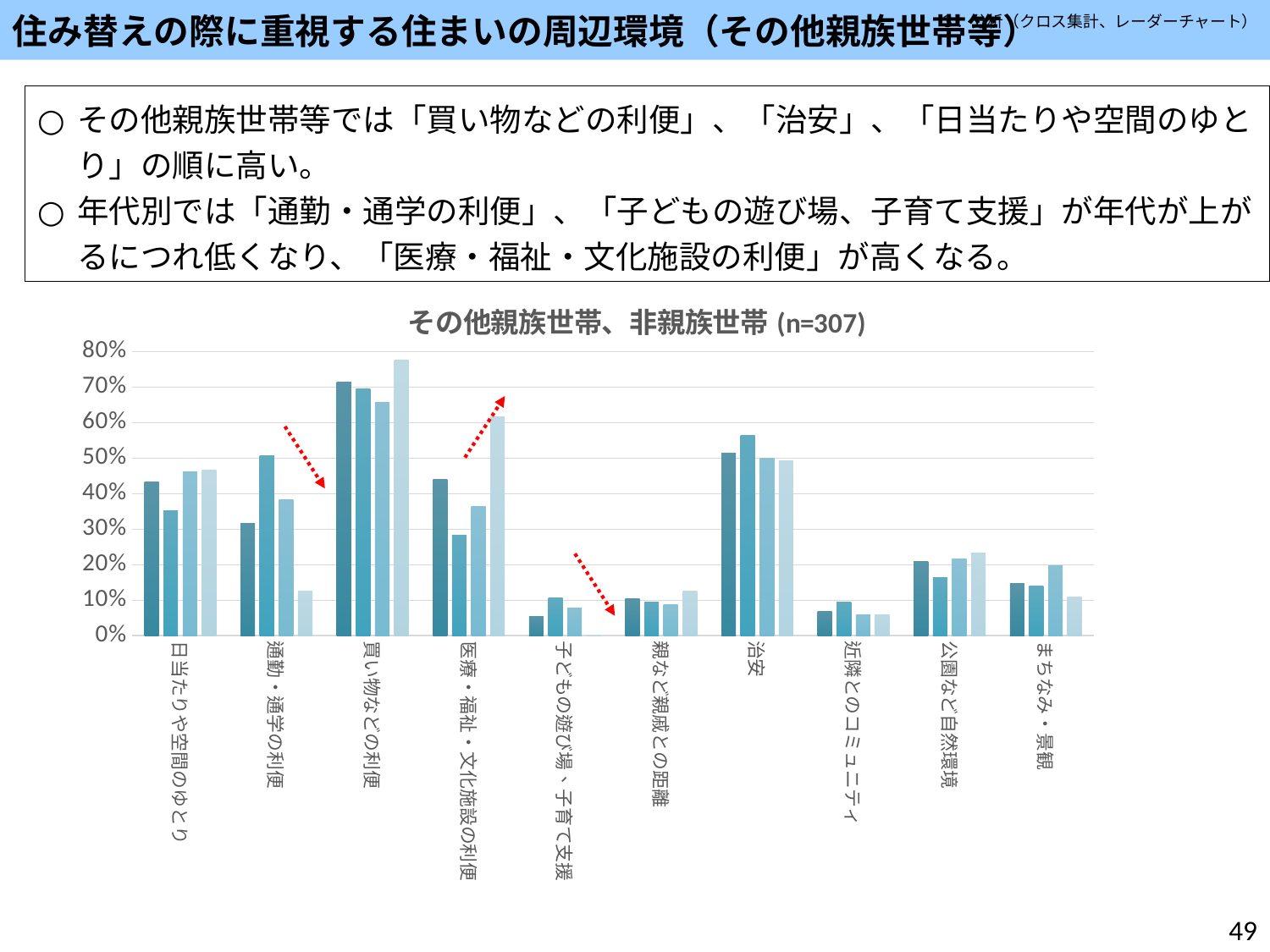
Which category has higher bars overall, 買い物などの利便 or 治安? 買い物などの利便 Is the first (darkest) bar for 日当たりや空間のゆとり greater or less than 40%? greater How many categories are shown on the x axis of the chart? 10 What kind of chart is shown on the slide? bar chart What sample size (n) is given in the chart title? 307 Are all the bars for 治安 greater or less than 40%? greater Are the bars for 近隣とのコミュニティ greater or less than 20%? less What is the title of the chart? その他親族世帯、非親族世帯 (n=307) Which category has the highest bars in the chart? 買い物などの利便 Which is larger, the first (darkest) bar for 日当たりや空間のゆとり or the first bar for 通勤・通学の利便? 日当たりや空間のゆとり